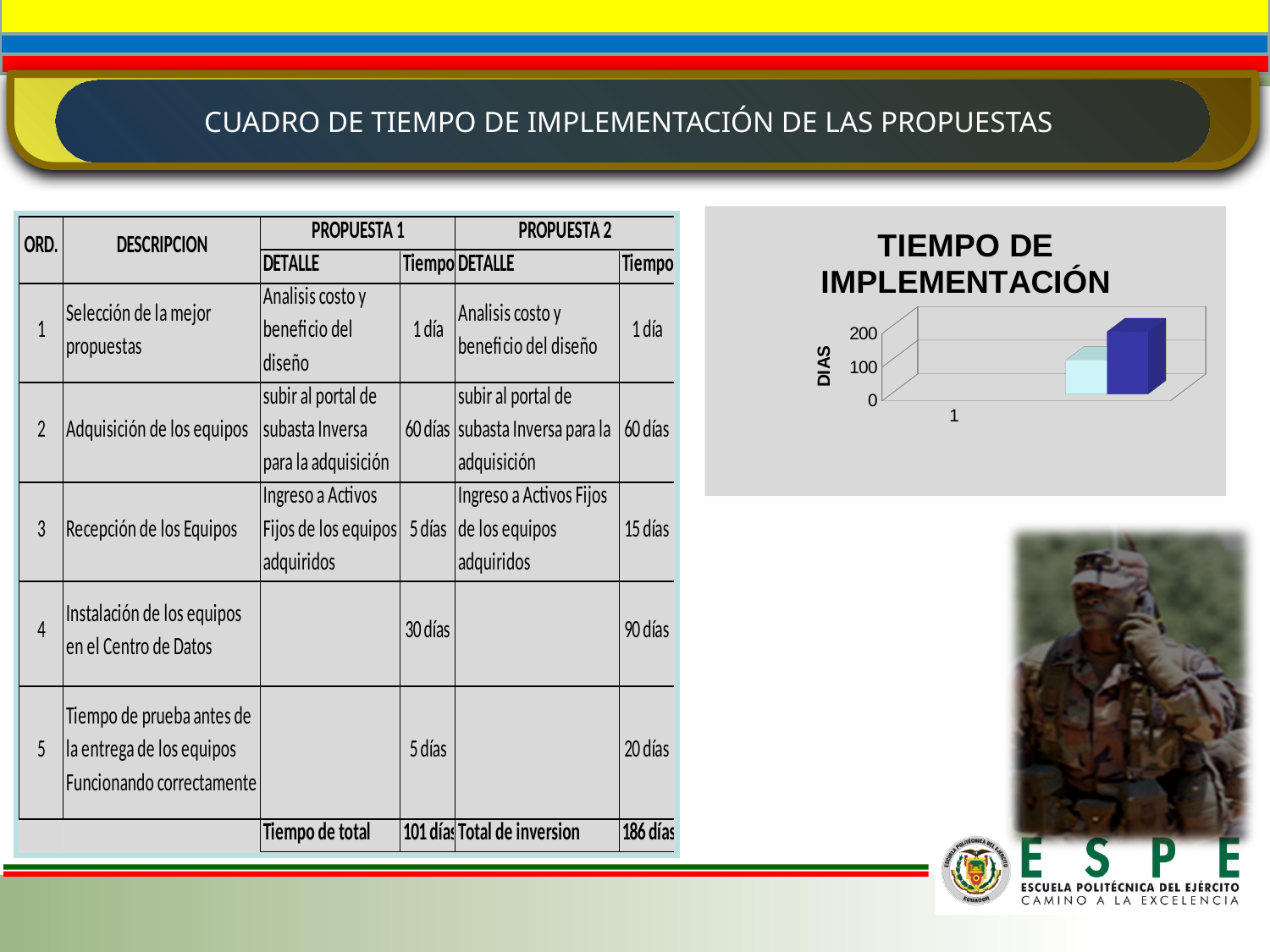
Is the value of the light blue bar greater or less than 200? less Is the value of the dark blue bar greater or less than 100? greater What is the title of the chart on the slide? TIEMPO DE IMPLEMENTACIÓN Which bar is taller in the chart, the light blue bar or the dark blue bar? dark blue bar What label is shown on the vertical axis of the chart? DIAS How many categories are shown on the x axis of the chart? 1 Which bar in the chart has the highest value? dark blue bar Which bar in the chart has the lowest value? light blue bar What is the highest tick value shown on the vertical axis of the chart? 200 What kind of chart is shown on the slide? bar chart How many bars are plotted in the chart? 2